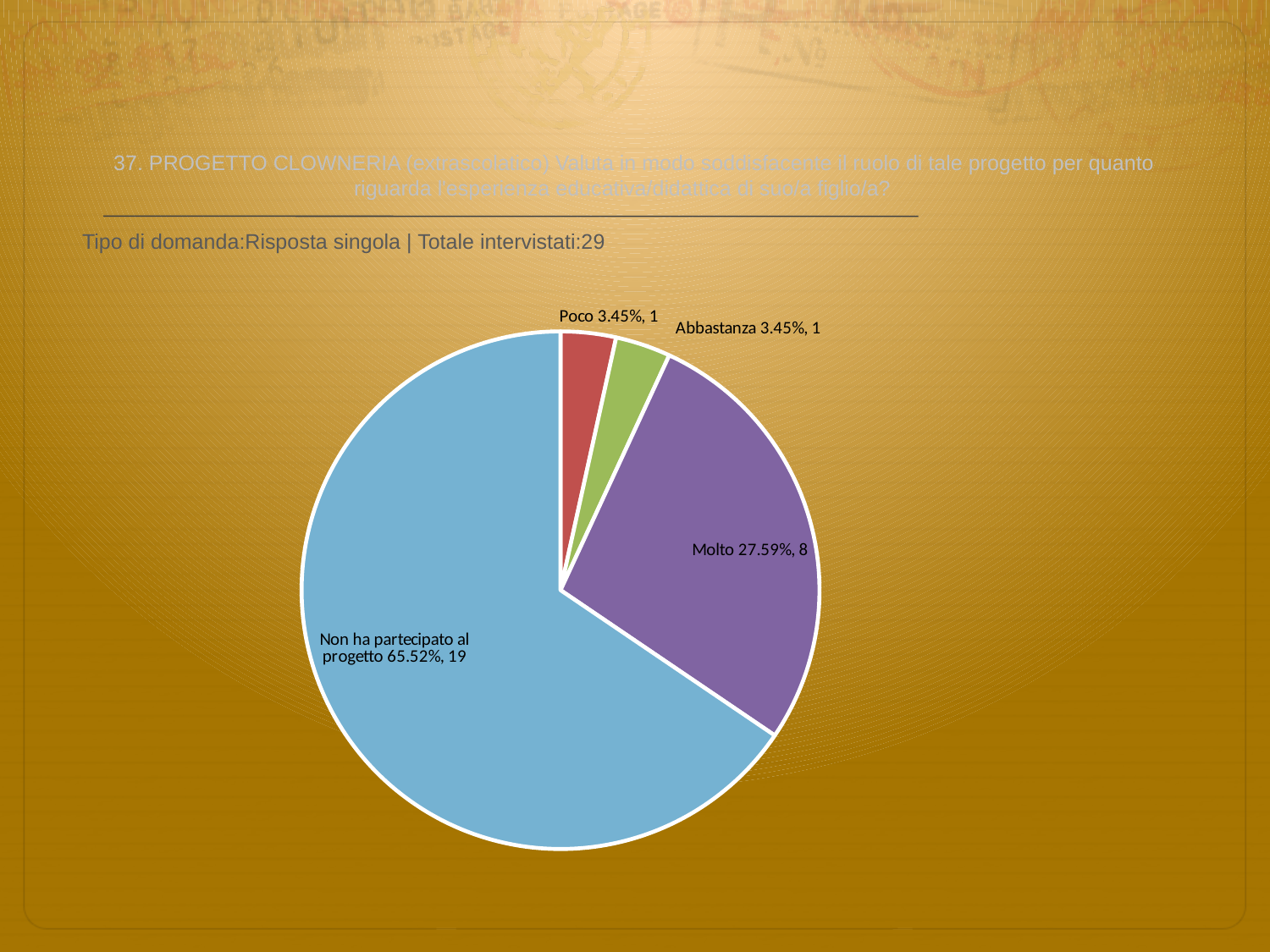
What colour is the 'Molto' slice? purple How many slices does the pie chart have? 4 What percentage share does the 'Non ha partecipato al progetto' slice have? 65.52% What is the difference in respondent count between 'Non ha partecipato al progetto' and 'Molto'? 11 How many respondents answered 'Non ha partecipato al progetto'? 19 What percentage share does the 'Molto' slice have? 27.59% Which category has the largest slice of the pie? Non ha partecipato al progetto Which is larger, the 'Molto' slice or the 'Abbastanza' slice? Molto How many respondents answered 'Molto'? 8 How many respondents answered 'Poco'? 1 What kind of chart is shown on the slide? pie chart What is the total number of respondents (Totale intervistati) stated on the slide? 29